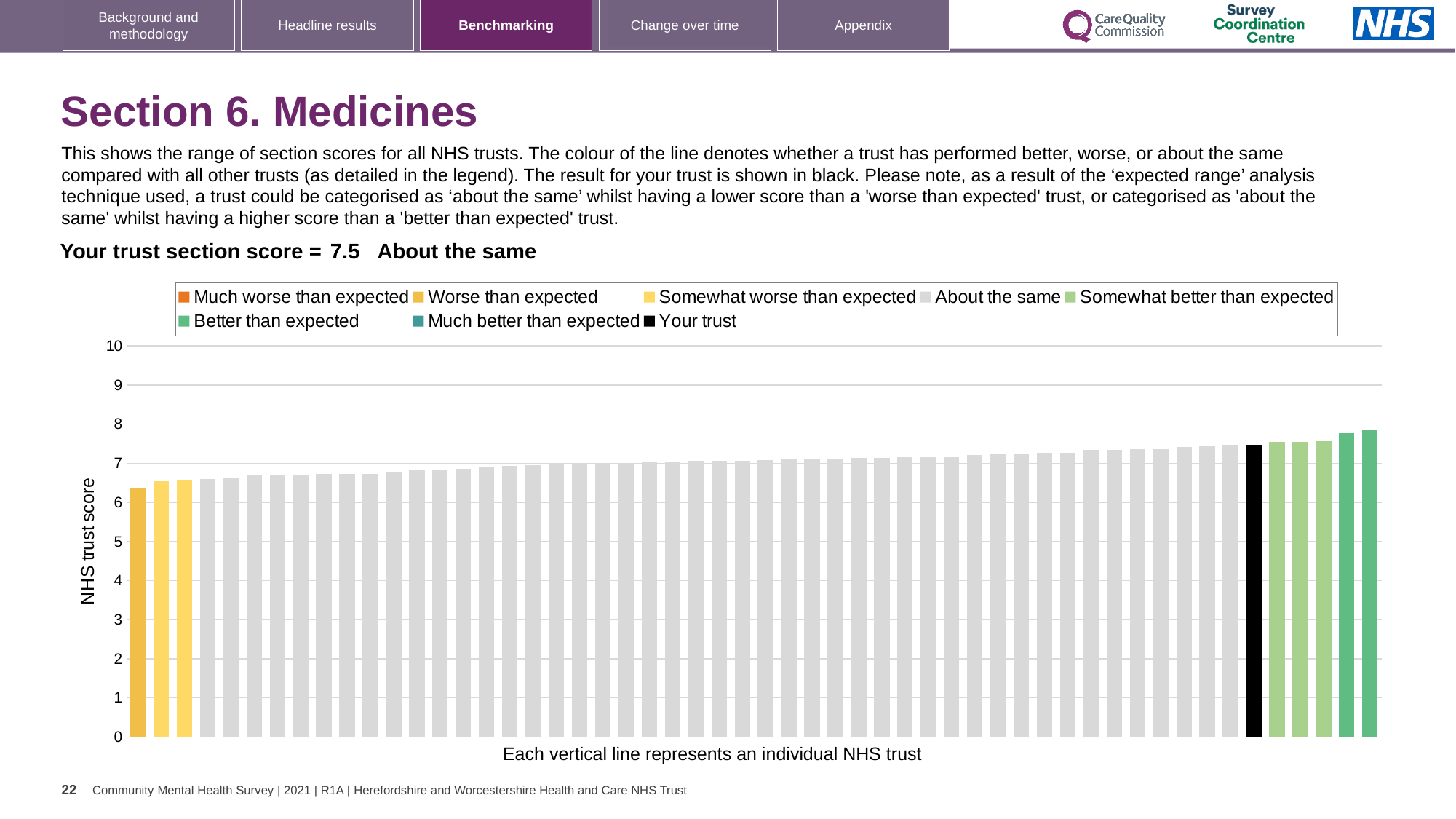
How is your trust categorised compared with other trusts on this slide? About the same What is the label on the vertical axis of the chart? NHS trust score Is the lowest bar in the chart greater or less than 6? greater What colour is the bar representing your trust? black Do the bar values rise or fall from left to right along the x axis? rise Is the highest bar in the chart greater or less than 8? less How many entries does the chart legend list? 8 Is the value for your trust greater or less than 7? greater What kind of chart is shown on the slide? bar chart What is the section score for your trust shown on the slide? 7.5